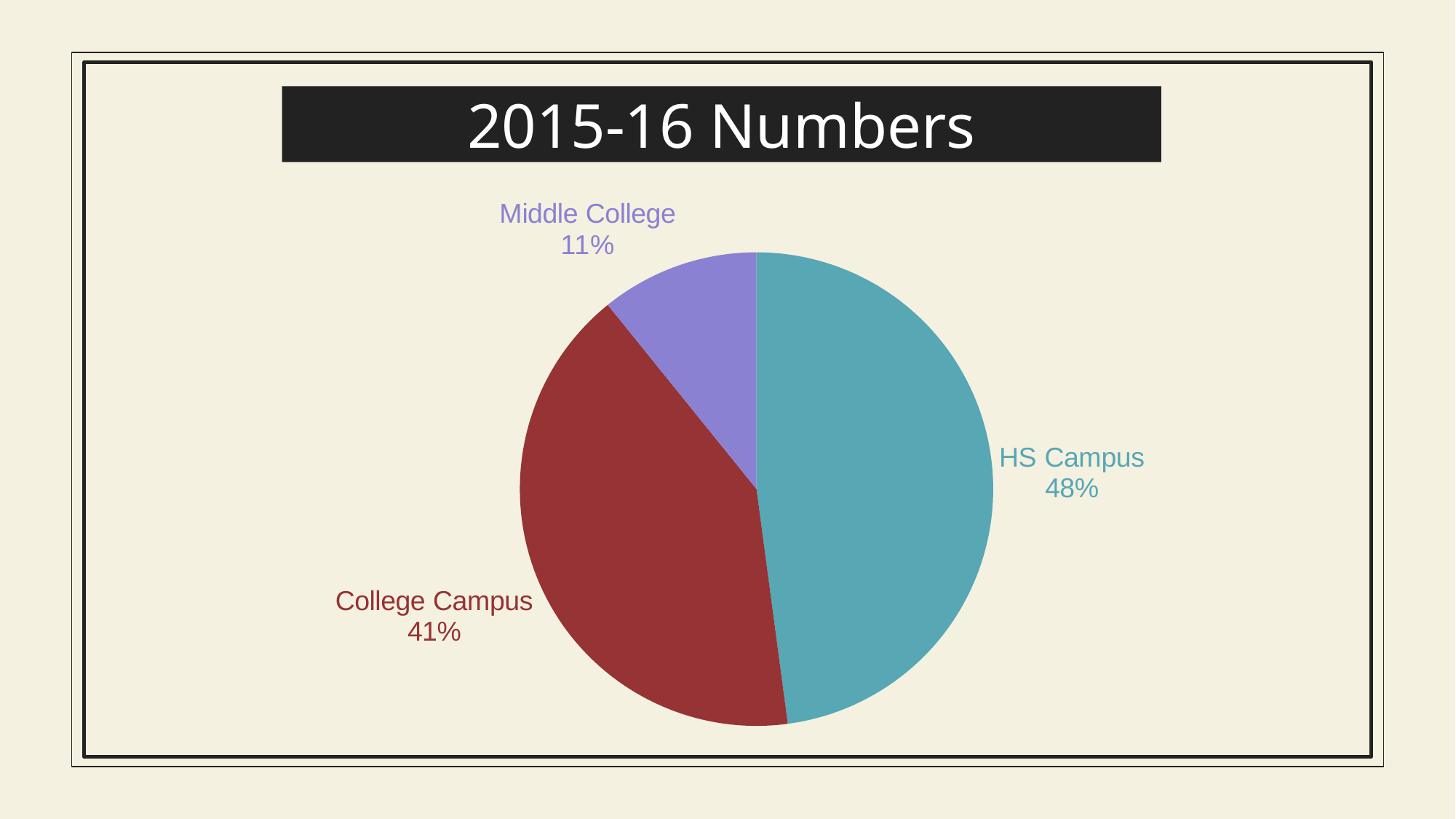
What share of the pie does HS Campus represent? 48% What share of the pie does Middle College represent? 11% How many slices does the pie chart have? 3 What is the difference in percentage points between College Campus and Middle College? 30 Which is larger, the share for College Campus or the share for Middle College? College Campus Which category has the largest slice of the pie? HS Campus What share of the pie does College Campus represent? 41% What is the difference in percentage points between HS Campus and College Campus? 7 What kind of chart is shown on the slide? pie chart Which category has the smallest slice of the pie? Middle College What is the title of the chart? 2015-16 Numbers What colour is the HS Campus slice? teal